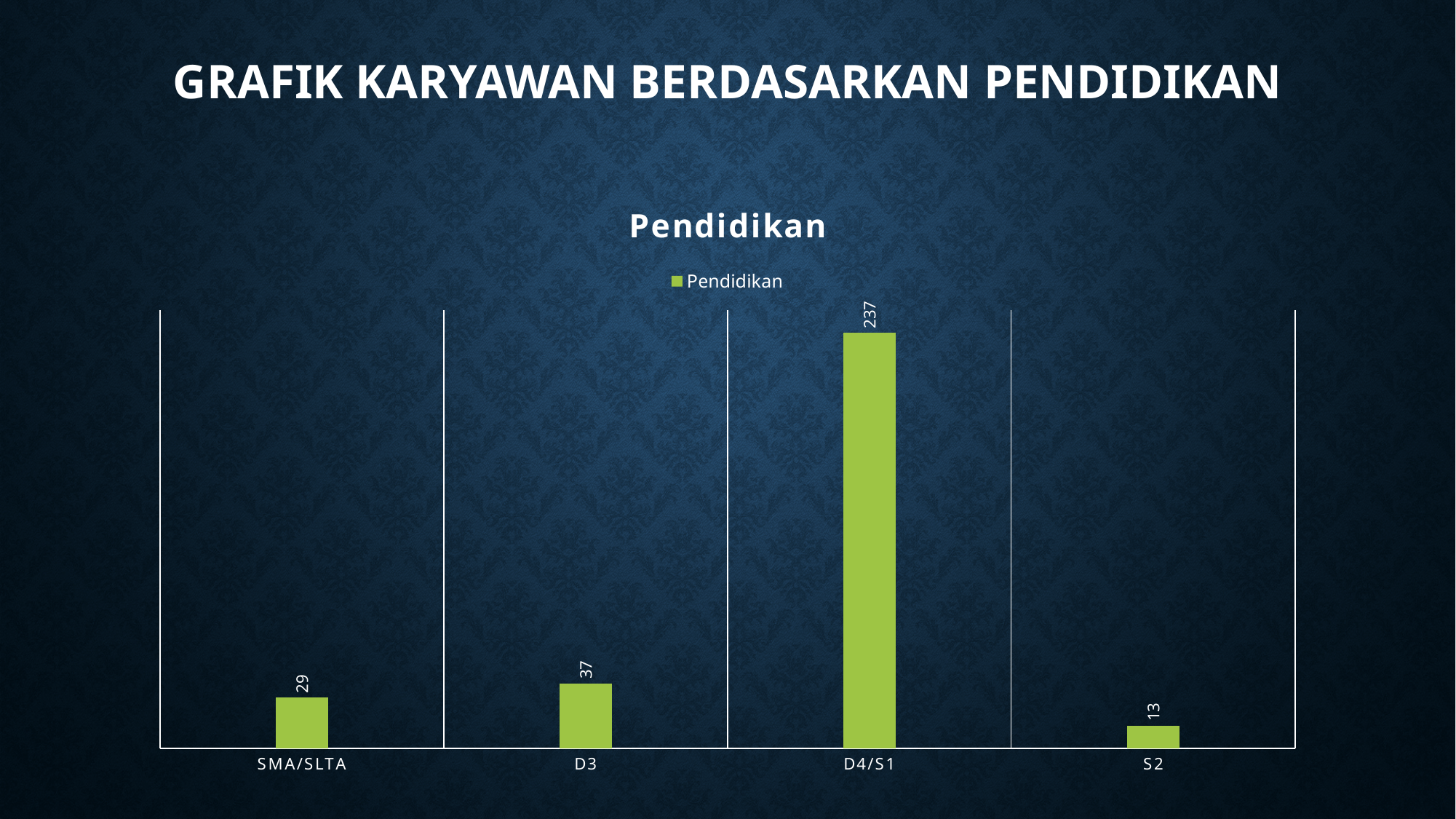
What is the value for D4/S1? 237 What is the title of the chart? Pendidikan What kind of chart is shown on the slide? bar chart What is the value for S2? 13 Which category has the lowest value? S2 What is the difference between the values for D4/S1 and D3? 200 What is the value for SMA/SLTA? 29 Which category has the highest value? D4/S1 What is the difference between the values for D3 and SMA/SLTA? 8 How many categories are shown on the x axis? 4 Which is larger, the value for SMA/SLTA or the value for S2? SMA/SLTA What is the value for D3? 37